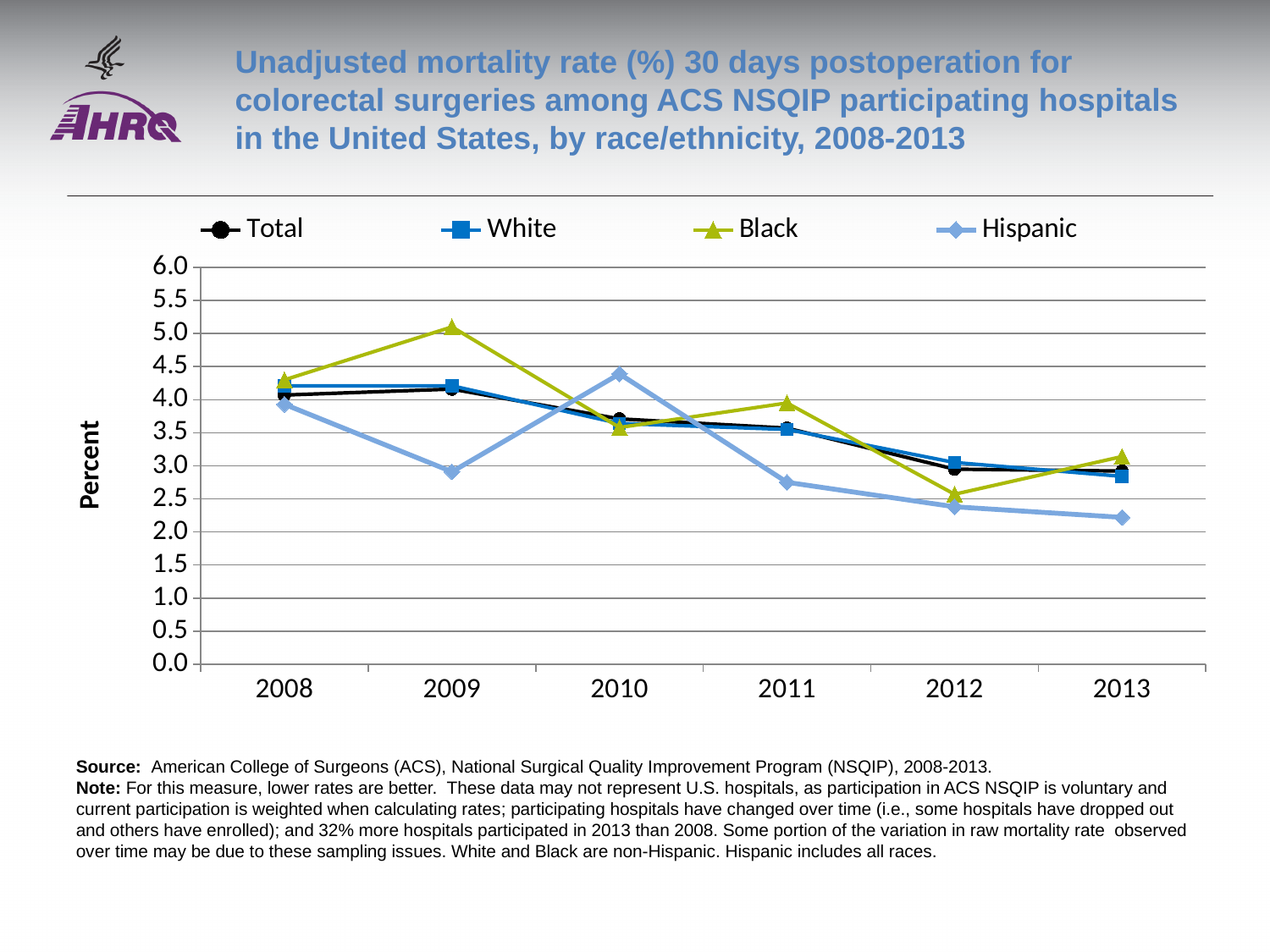
What kind of chart is shown on the slide? line chart In 2011, which is larger: the value for Black or the value for Hispanic? Black Is the value for Black in 2009 greater or less than 4.5? greater Is the value for Total in 2008 greater or less than 3.5? greater Does the Hispanic series rise or fall from 2010 to 2013? fall How many series does the legend list? 4 Is the value for Hispanic in 2013 greater or less than 2.5? less Which series has the highest value in 2009? Black How many years are plotted along the x axis? 6 Which series has the lowest value in 2013? Hispanic In which year does the Black series reach its highest value? 2009